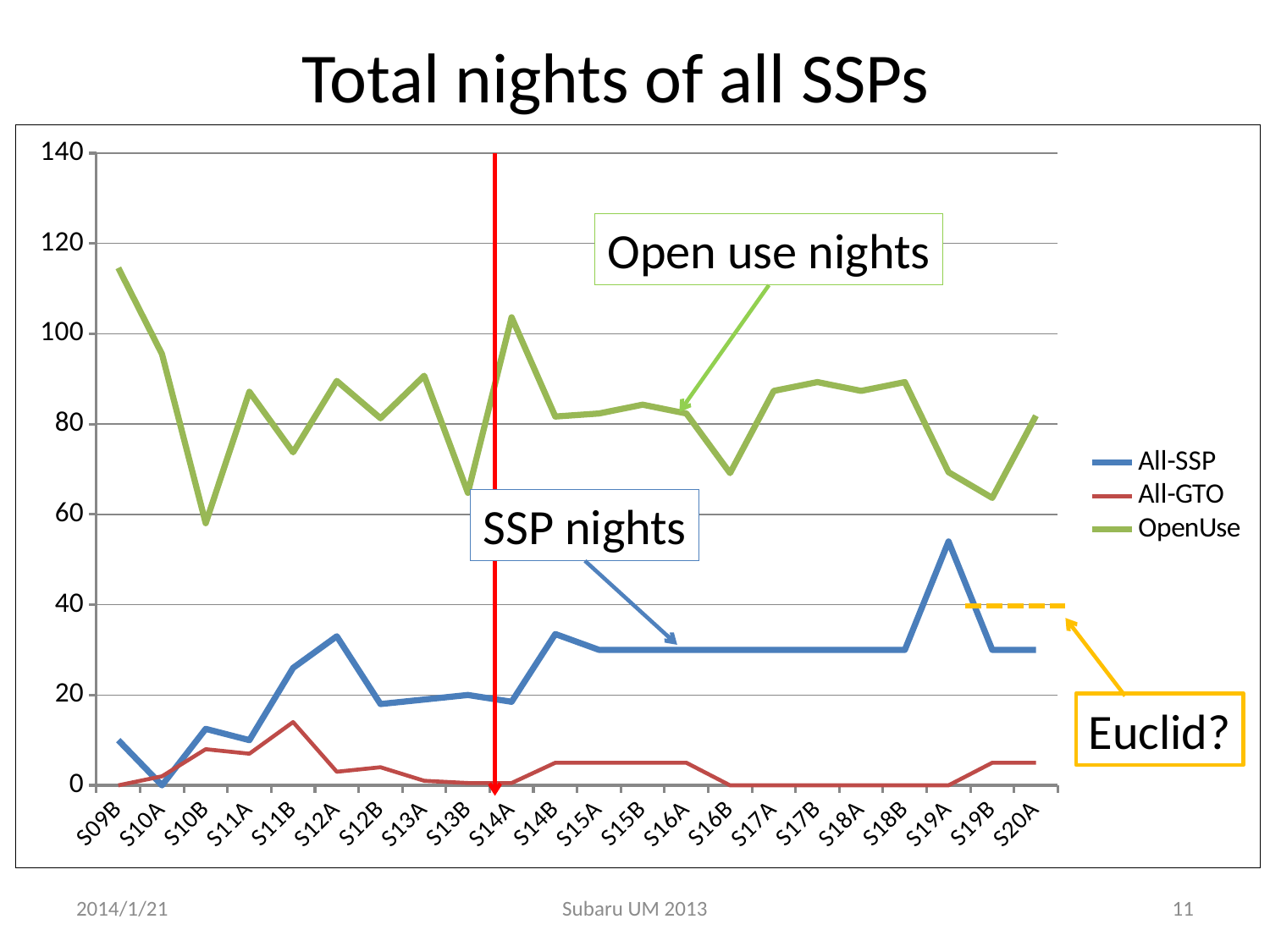
Which semester has the lowest OpenUse value? S10B What is the All-GTO value for S17A? 0 Which semester has the highest OpenUse value? S09B How many series does the legend list? 3 Which semester has the highest All-SSP value? S19A Which series has the larger value at S09B, OpenUse or All-SSP? OpenUse Is the All-SSP value for S19A greater or less than 40? greater What kind of chart is shown on the slide? line chart What is the title of the chart? Total nights of all SSPs Is the All-GTO value for S11B greater or less than 20? less Is the OpenUse value for S09B greater or less than 100? greater How many semesters (categories) are shown along the x axis? 22